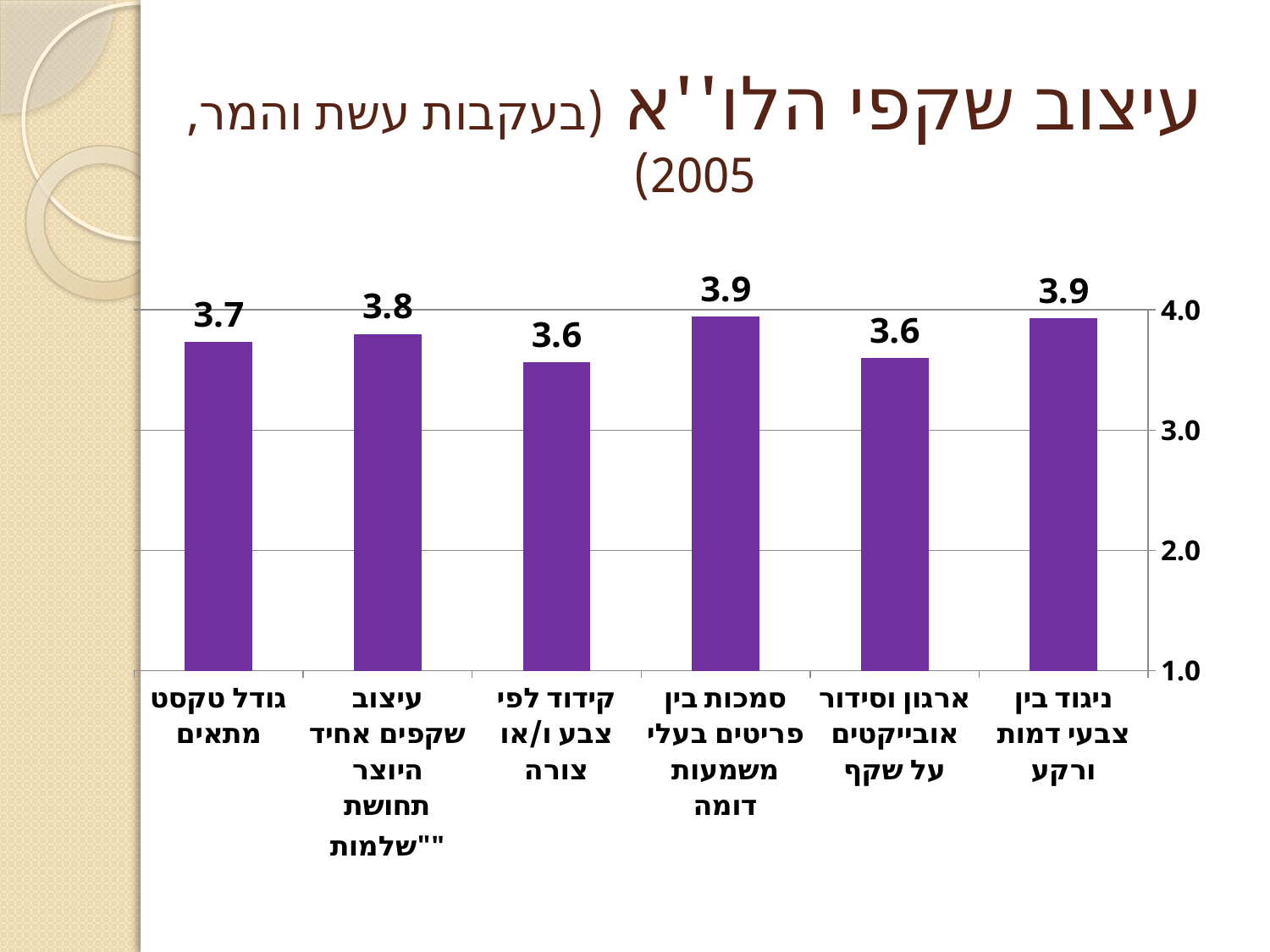
How many categories are shown in the chart? 6 What is the difference between the values for סמכות בין פריטים בעלי משמעות דומה and קידוד לפי צבע ו/או צורה? 0.3 What is the highest value shown in the chart? 3.9 What is the value for ארגון וסידור אובייקטים על שקף? 3.6 What is the value for קידוד לפי צבע ו/או צורה? 3.6 What kind of chart is shown on the slide? Bar chart What is the lowest value shown in the chart? 3.6 What is the lowest value shown on the vertical axis? 1.0 What is the value for עיצוב שקפים אחיד היוצר תחושת "שלמות"? 3.8 What is the value for גודל טקסט מתאים? 3.7 What is the value for ניגוד בין צבעי דמות ורקע? 3.9 Which has a larger value, גודל טקסט מתאים or עיצוב שקפים אחיד היוצר תחושת "שלמות"? עיצוב שקפים אחיד היוצר תחושת "שלמות"